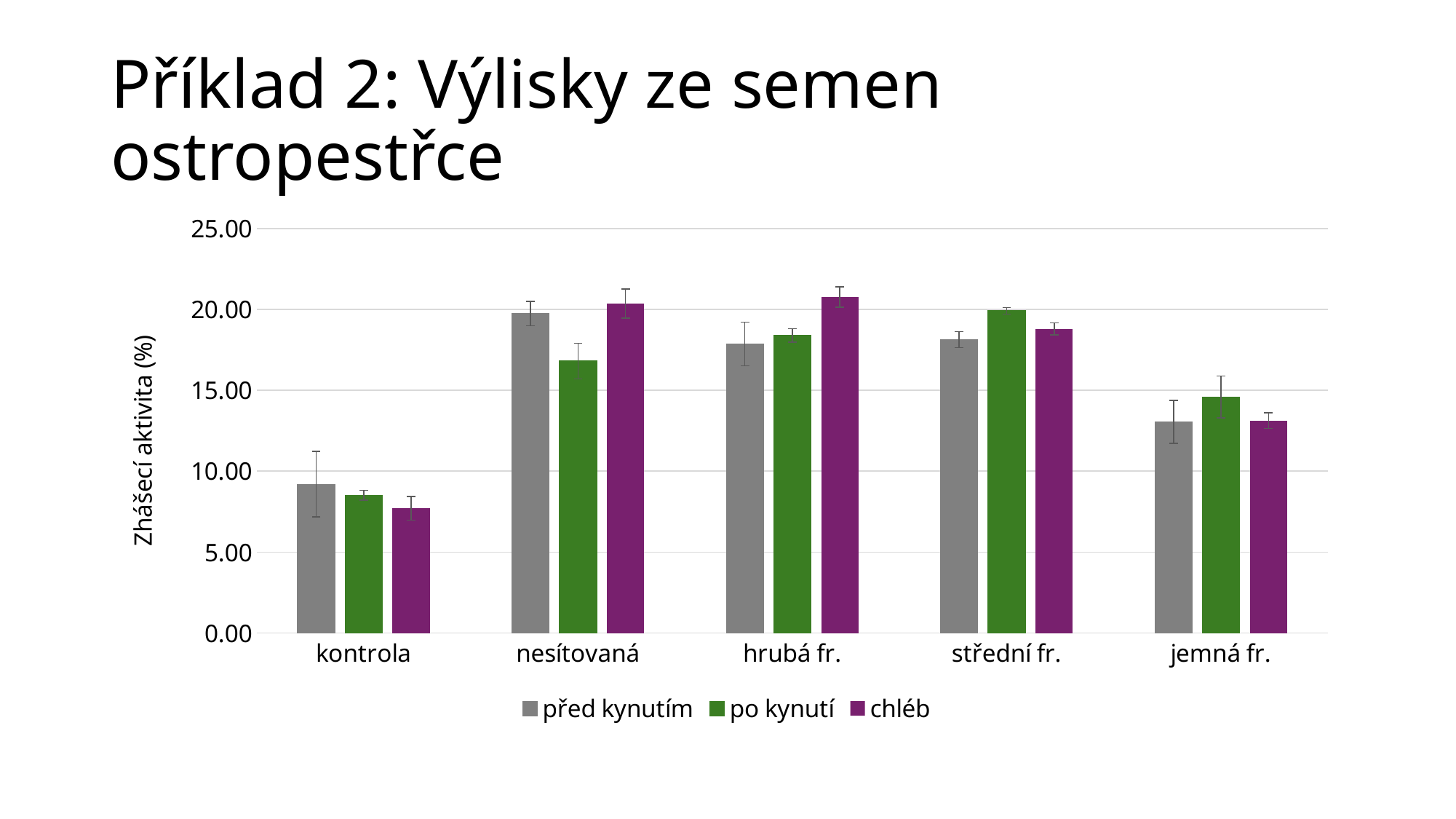
How many series does the legend list? 3 What kind of chart is shown on the slide? bar chart Is the value for 'před kynutím' in the 'kontrola' category greater or less than 10.00? less Which category has the highest value for the 'po kynutí' series? střední fr. How many categories are shown on the x axis of the chart? 5 In the 'nesítovaná' category, which is larger: 'před kynutím' or 'po kynutí'? před kynutím Is the value for 'po kynutí' in the 'nesítovaná' category greater or less than 15.00? greater Is the value for 'po kynutí' in the 'jemná fr.' category greater or less than 15.00? less Which category has the lowest value for the 'chléb' series? kontrola What is the label of the y axis? Zhášecí aktivita (%) Which colour represents the series 'chléb' in the legend? purple